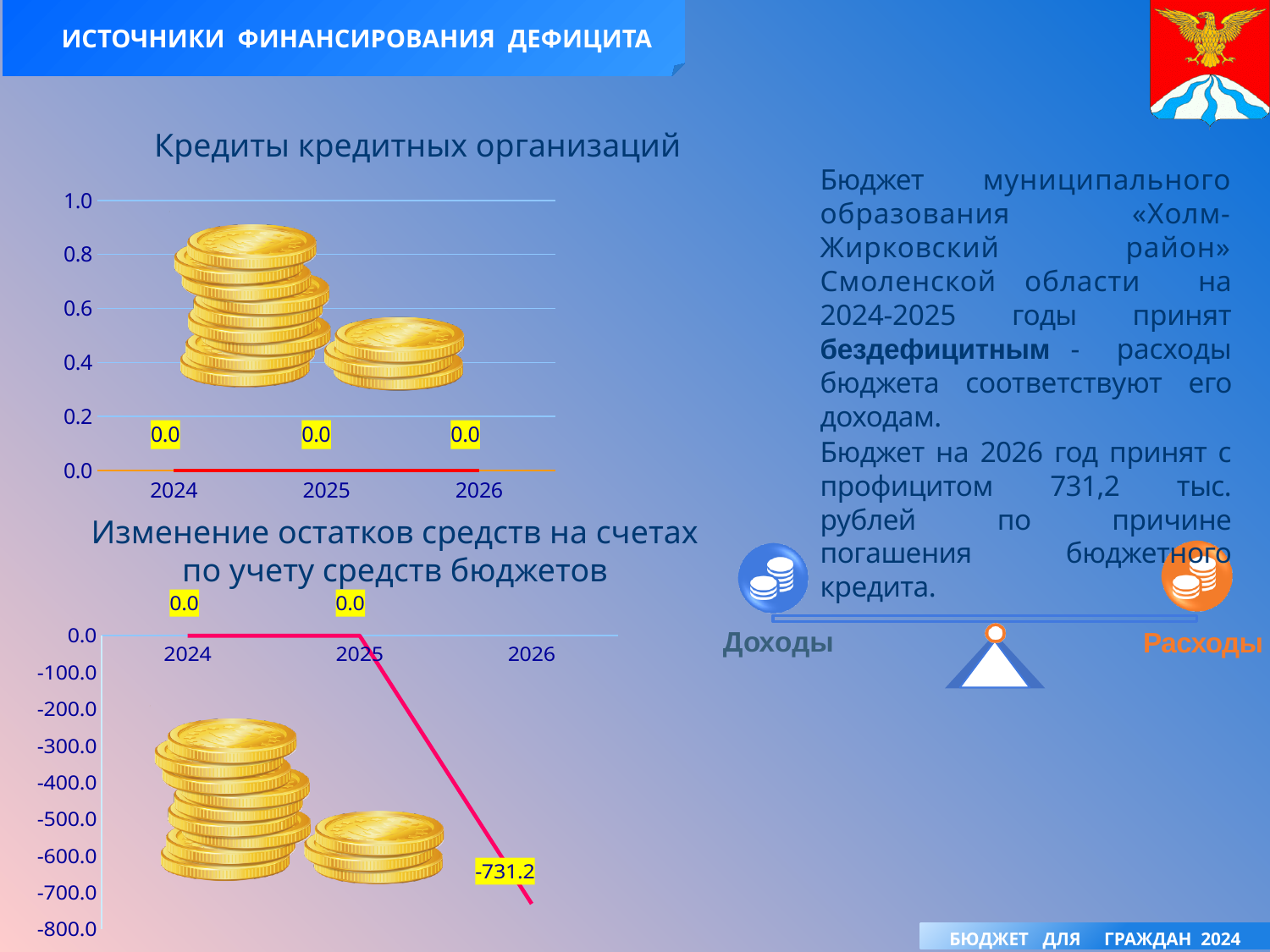
What type of chart is 'Кредиты кредитных организаций'? line chart What is the title of the lower chart on the slide? Изменение остатков средств на счетах по учету средств бюджетов In the chart 'Изменение остатков средств на счетах по учету средств бюджетов', what is the value for 2026? -731.2 In the chart 'Кредиты кредитных организаций', what is the value for 2026? 0.0 In the chart 'Кредиты кредитных организаций', what is the value for 2024? 0.0 In the chart 'Изменение остатков средств на счетах по учету средств бюджетов', which is larger, the value for 2024 or the value for 2026? 2024 In the chart 'Изменение остатков средств на счетах по учету средств бюджетов', what is the difference between the values for 2025 and 2026? 731.2 In the chart 'Изменение остатков средств на счетах по учету средств бюджетов', do the values rise or fall from 2025 to 2026? fall In the chart 'Изменение остатков средств на счетах по учету средств бюджетов', what is the value for 2024? 0.0 In the chart 'Изменение остатков средств на счетах по учету средств бюджетов', is the value for 2026 greater or less than -700.0? less In the chart 'Изменение остатков средств на счетах по учету средств бюджетов', which year has the lowest value? 2026 How many years are plotted in the chart 'Кредиты кредитных организаций'? 3